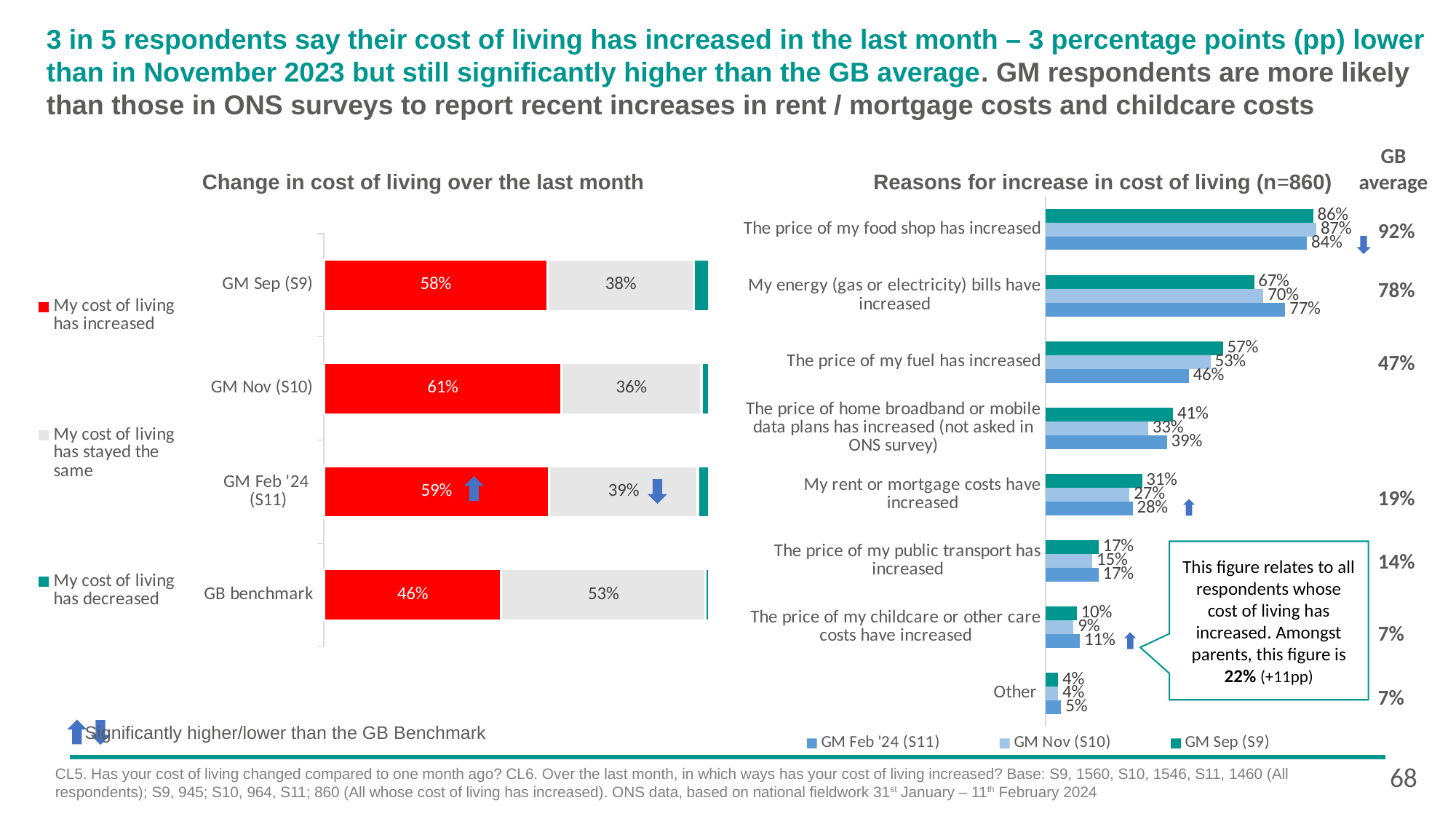
In the 'Reasons for increase in cost of living (n=860)' chart, which reason has the highest GM Feb '24 (S11) value? The price of my food shop has increased In the 'Reasons for increase in cost of living (n=860)' chart, how many reason categories are shown? 8 In the 'Change in cost of living over the last month' chart, how many series does the legend list? 3 In the 'Reasons for increase in cost of living (n=860)' chart, which is larger for 'The price of my fuel has increased': the GM Sep (S9) value or the GM Feb '24 (S11) value? GM Sep (S9) In the 'Reasons for increase in cost of living (n=860)' chart, what is the GM Feb '24 (S11) value for 'My energy (gas or electricity) bills have increased'? 77% What type of chart is 'Change in cost of living over the last month'? Stacked bar chart In the 'Change in cost of living over the last month' chart, what percentage of GB benchmark respondents said their cost of living has stayed the same? 53% In the 'Change in cost of living over the last month' chart, what is the difference in percentage points between the 'increased' share for GM Nov (S10) and GM Feb '24 (S11)? 2 percentage points In the 'Reasons for increase in cost of living (n=860)' chart, what is the GB average shown for 'My rent or mortgage costs have increased'? 19% In the 'Change in cost of living over the last month' chart, which category has the lowest share saying their cost of living has increased? GB benchmark In the 'Reasons for increase in cost of living (n=860)' chart, what is the GM Sep (S9) value for 'The price of my fuel has increased'? 57% In the 'Change in cost of living over the last month' chart, what percentage of GM Nov (S10) respondents said their cost of living has increased? 61%